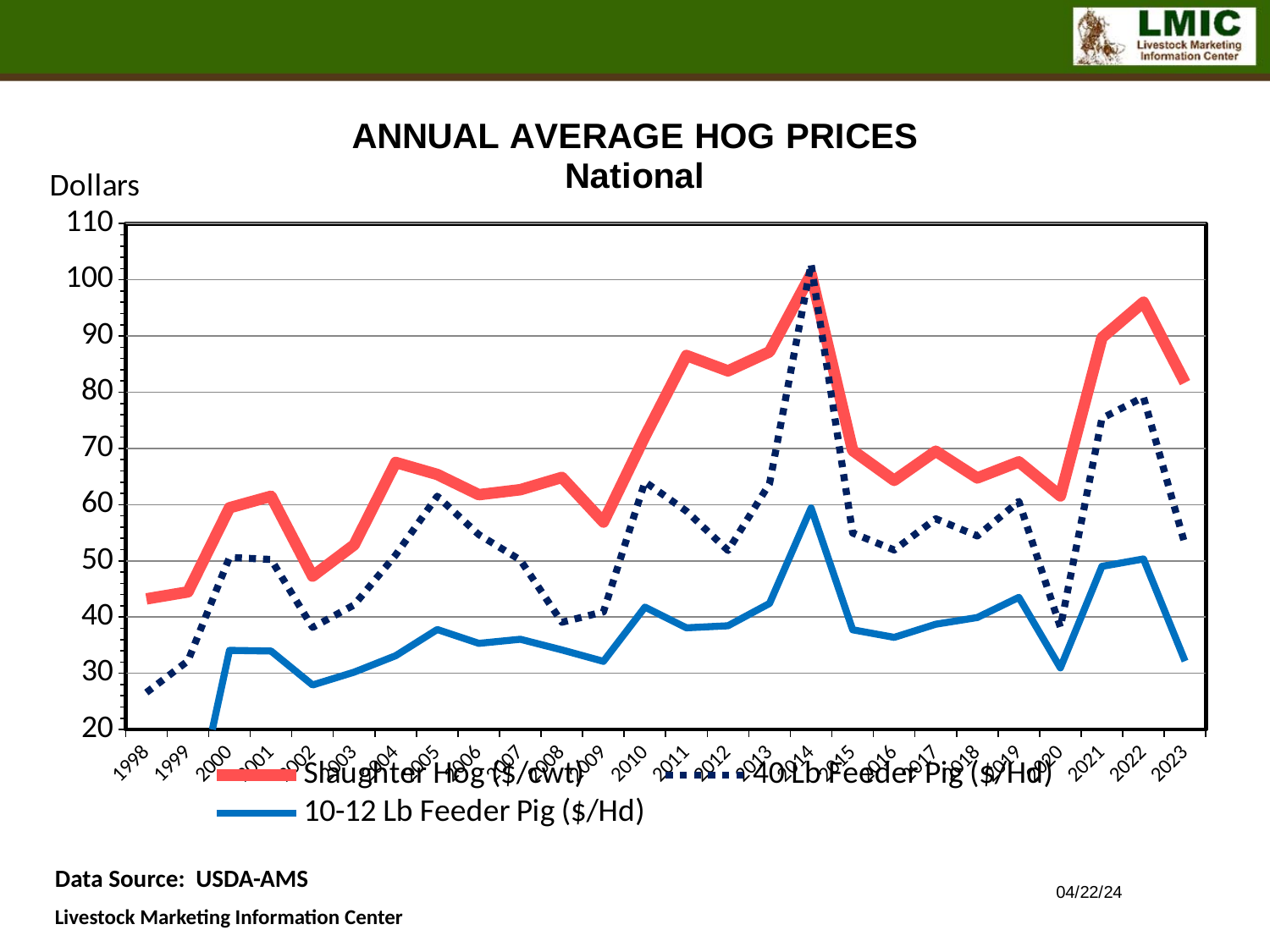
In which year does the Slaughter Hog ($/cwt) series reach its highest value? 2014 Does the Slaughter Hog ($/cwt) series rise or fall from 2014 to 2016? fall Is the 40 Lb Feeder Pig ($/Hd) value for 2022 greater or less than 70? greater Is the 40 Lb Feeder Pig ($/Hd) value for 1998 greater or less than 30? less Which is larger for Slaughter Hog ($/cwt): the value in 2009 or the value in 2011? 2011 How many years are plotted along the x axis? 26 In which year does the 10-12 Lb Feeder Pig ($/Hd) series reach its highest value? 2014 Is the 10-12 Lb Feeder Pig ($/Hd) value for 2020 greater or less than 40? less What is the label on the vertical axis of the chart? Dollars How many series does the legend list? 3 What kind of chart is shown on the slide? line chart